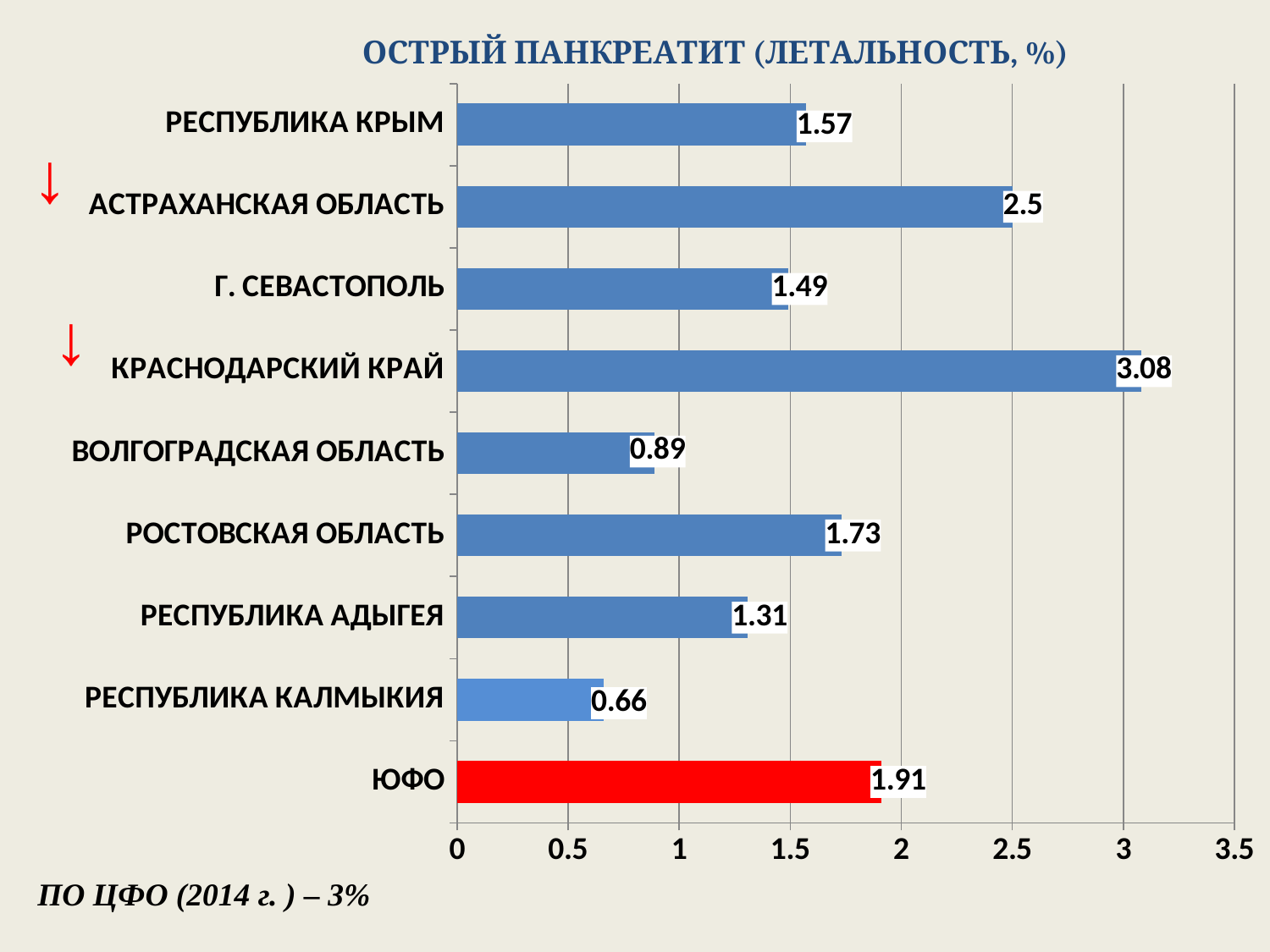
Which category has the highest value? Краснодарский край Which category's bar is coloured red? ЮФО Which category has the lowest value? Республика Калмыкия What is the value for ЮФО? 1.91 What is the difference between the values for Астраханская область and Г. Севастополь? 1.01 What is the value for Краснодарский край? 3.08 What is the title of the chart? ОСТРЫЙ ПАНКРЕАТИТ (ЛЕТАЛЬНОСТЬ, %) What is the value for Республика Калмыкия? 0.66 What kind of chart is shown on the slide? bar chart Which is larger, the value for Ростовская область or the value for Республика Адыгея? Ростовская область Is the value for Волгоградская область greater or less than 1? less How many categories are shown in the chart? 9